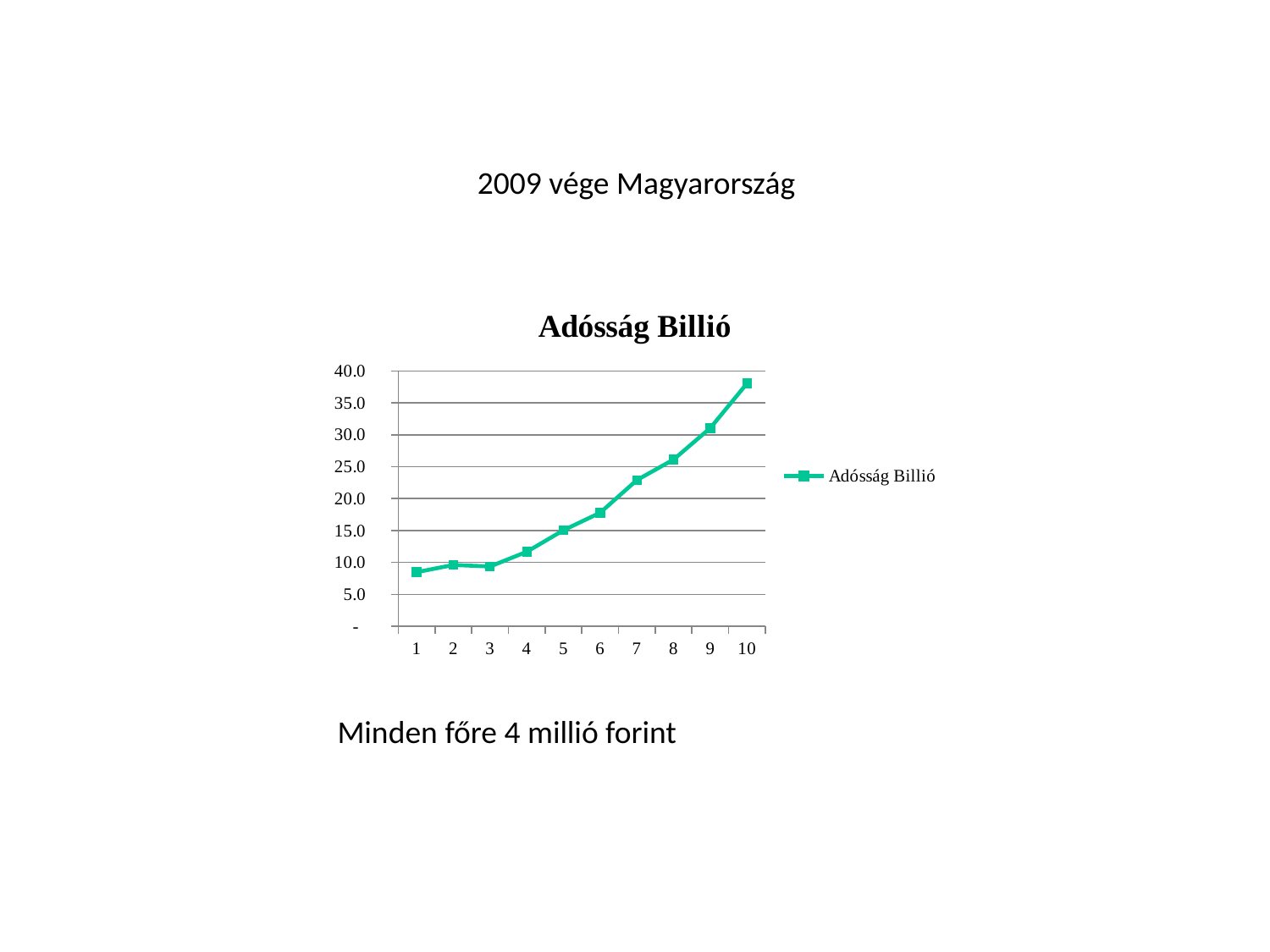
How many series does the legend list? 1 How many points are plotted along the x axis? 10 Which x-axis category has the lowest value? 1 Is the value for category 9 greater or less than 35.0? less Which x-axis category has the highest value? 10 What kind of chart is shown on the slide? line chart Is the value for category 7 greater or less than 20.0? greater Do the values generally rise or fall from category 1 to category 10? rise Is the value for category 10 greater or less than 35.0? greater What is the title of the chart? Adósság Billió Which is larger, the value for category 2 or the value for category 6? 6